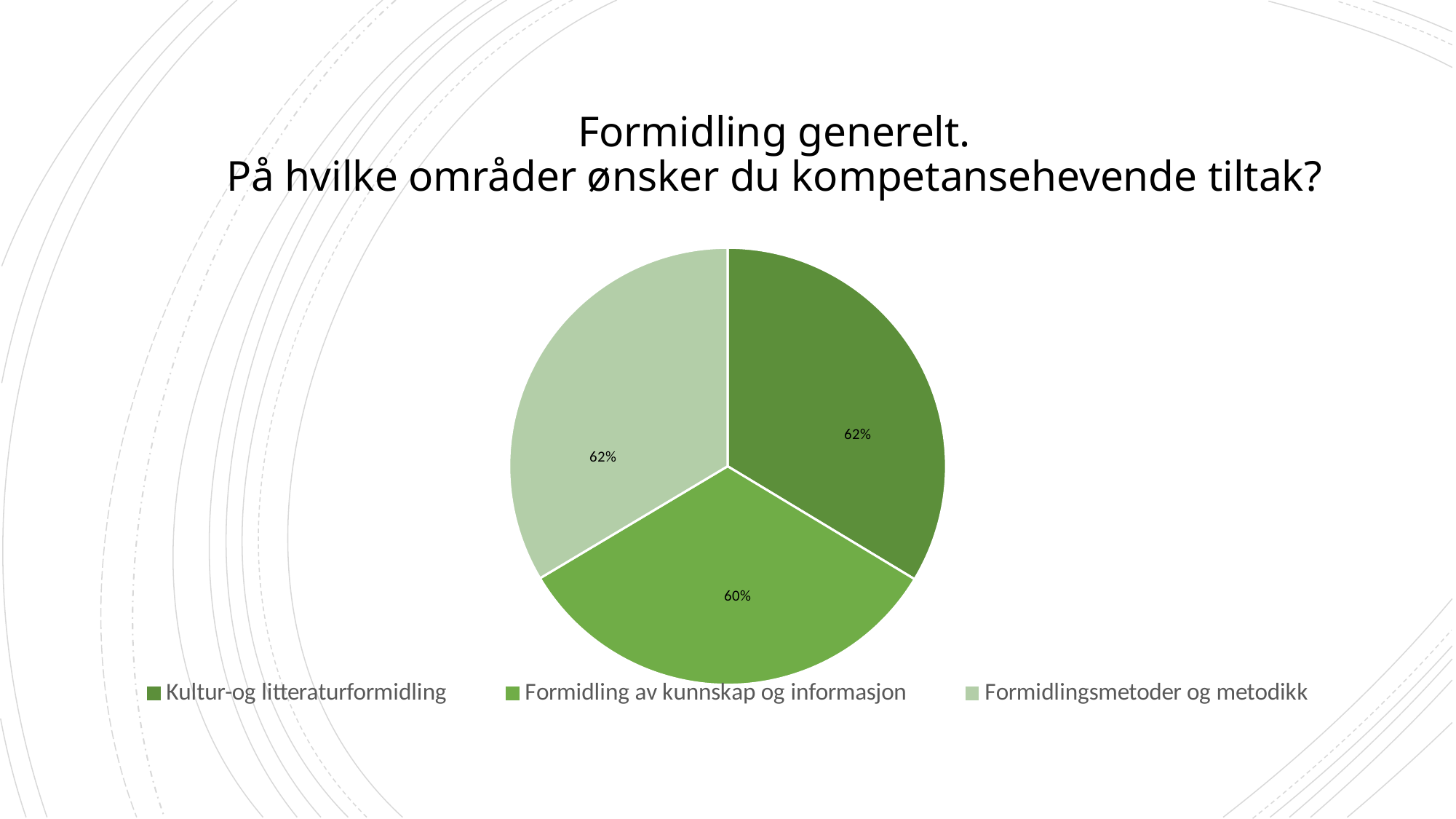
What is the title of the chart? Formidling generelt. På hvilke områder ønsker du kompetansehevende tiltak? How many entries does the legend list? 3 What is the value shown for Formidlingsmetoder og metodikk? 62% Which legend entry is shown in the lightest green colour? Formidlingsmetoder og metodikk What is the value shown for Formidling av kunnskap og informasjon? 60% What kind of chart is shown on the slide? pie chart What is the difference between the value for Formidlingsmetoder og metodikk and the value for Formidling av kunnskap og informasjon? 2 percentage points Which is larger: the value for Kultur-og litteraturformidling or the value for Formidling av kunnskap og informasjon? Kultur-og litteraturformidling Which category has the lowest value in the pie chart? Formidling av kunnskap og informasjon How many slices does the pie chart have? 3 What is the value shown for Kultur-og litteraturformidling? 62%